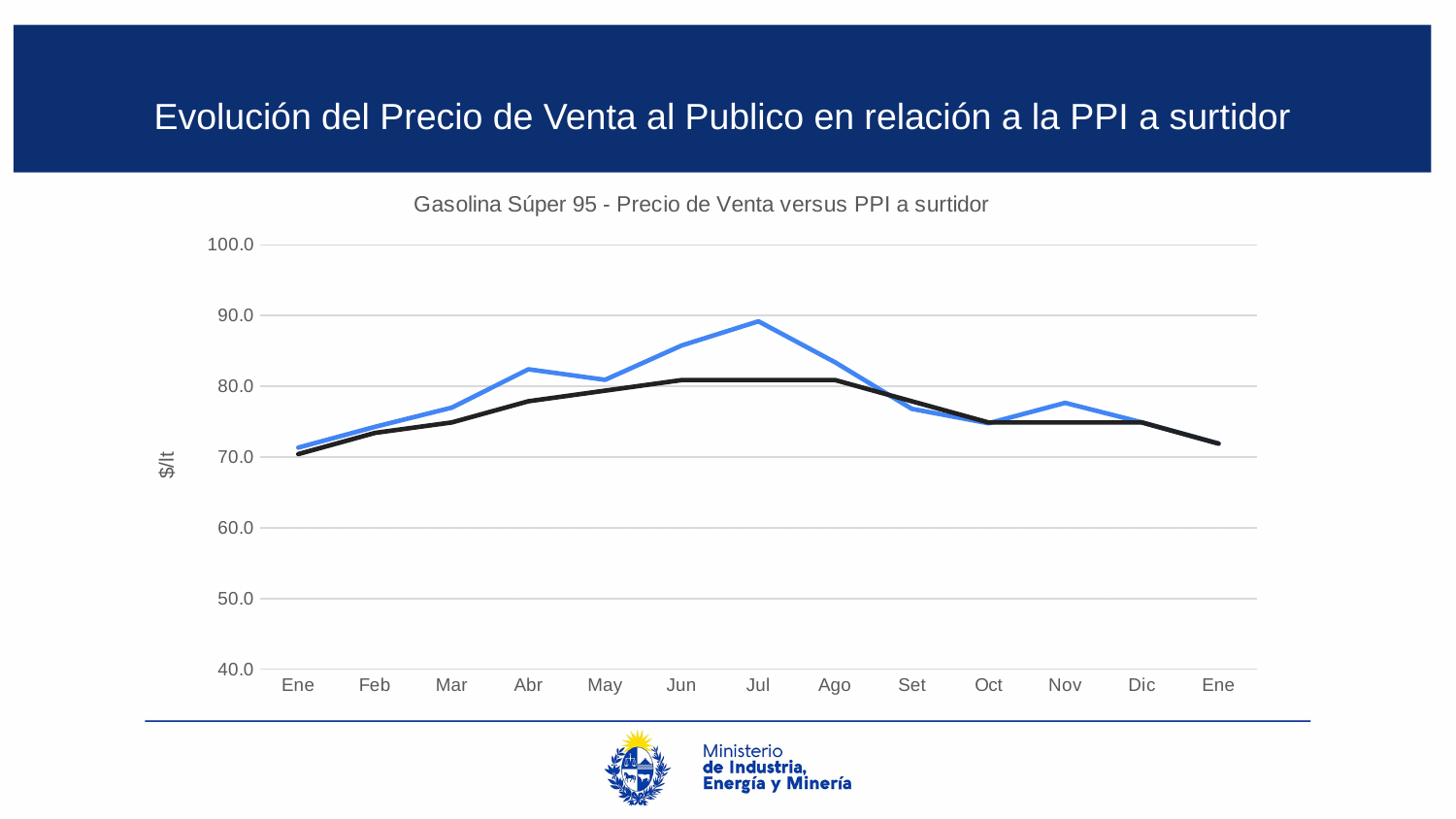
Does the blue line rise or fall from Jul to Oct? fall What is the label on the vertical axis of the chart? $/lt What is the title of the chart? Gasolina Súper 95 - Precio de Venta versus PPI a surtidor Is the value of the black line in Oct greater or less than 80? less In Jul, which line has the higher value, the blue line or the black line? blue line How many month labels are shown along the x axis? 13 Is the value of the blue line in Abr greater or less than 80? greater Is the value of the blue line in Jul greater or less than 80? greater In which month is the blue line at its lowest value? Ene (first) In which month does the blue line reach its highest value? Jul What kind of chart is shown on the slide? line chart